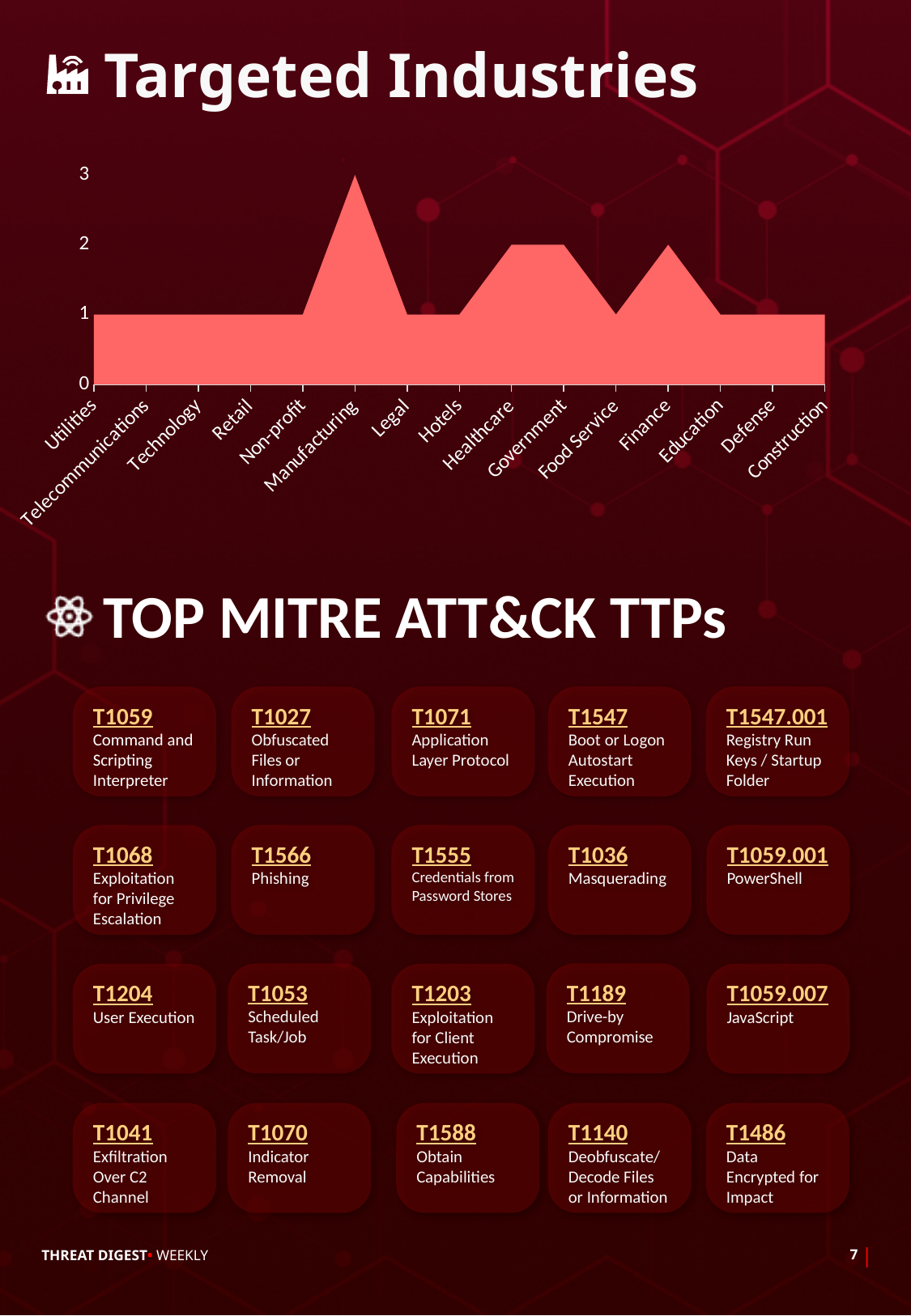
What is the value for Healthcare in the Targeted Industries chart? 2 How many industries are shown on the x axis of the Targeted Industries chart? 15 What is the value for Finance in the Targeted Industries chart? 2 Which has a larger value in the Targeted Industries chart, Manufacturing or Finance? Manufacturing Which industry has the highest value in the Targeted Industries chart? Manufacturing What kind of chart is the Targeted Industries chart? Area chart What is the value for Utilities in the Targeted Industries chart? 1 What is the value for Government in the Targeted Industries chart? 2 Is the value for Manufacturing in the Targeted Industries chart greater or less than 2? greater What is the value for Manufacturing in the Targeted Industries chart? 3 What is the difference between the values for Manufacturing and Healthcare in the Targeted Industries chart? 1 Which has a larger value in the Targeted Industries chart, Government or Education? Government